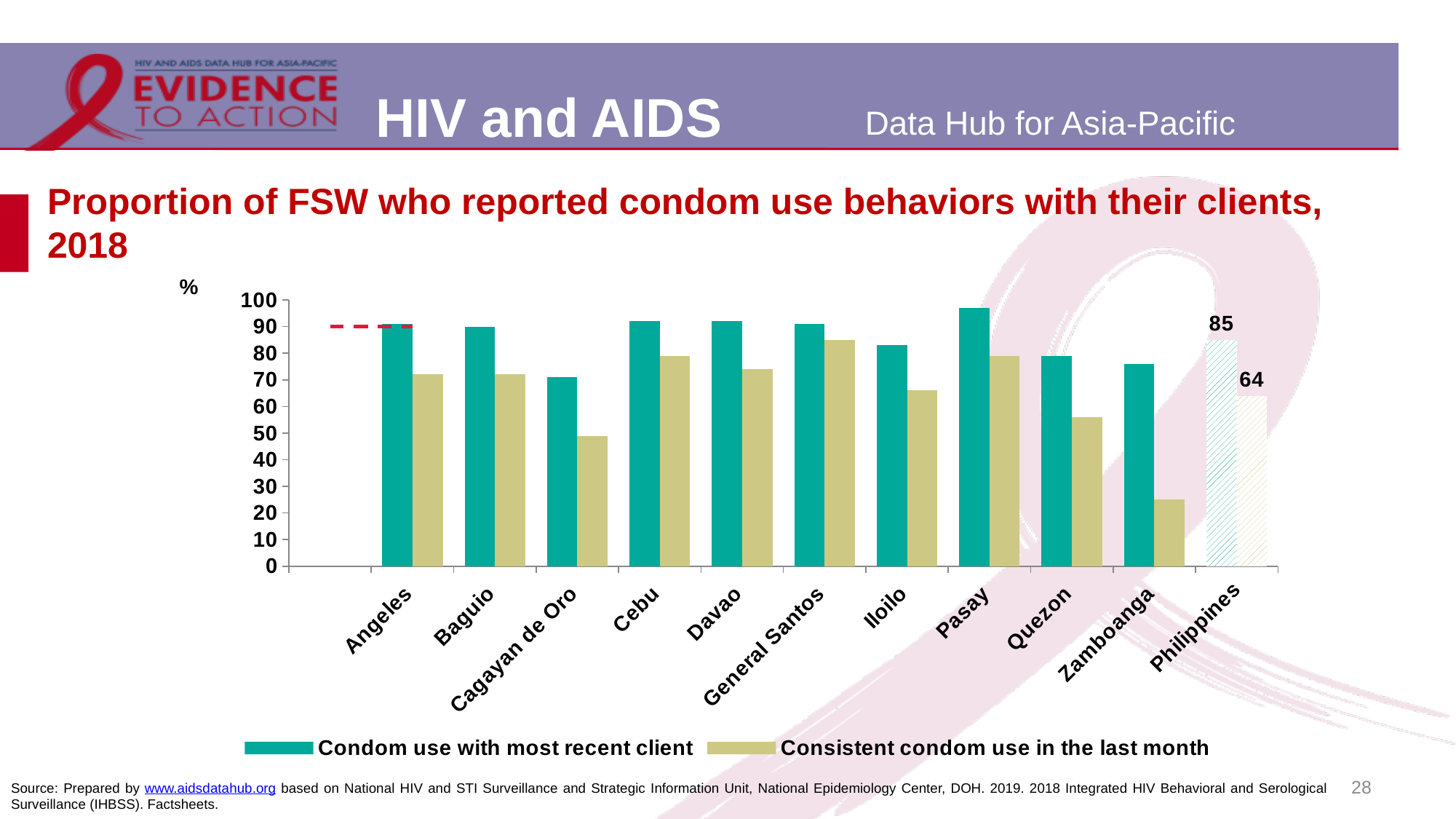
What kind of chart is shown on the slide? Bar chart Which category has the lowest value for 'Consistent condom use in the last month'? Zamboanga How many categories are shown on the x axis? 11 Which category has the highest value for 'Consistent condom use in the last month'? General Santos What is the value for Philippines in the 'Consistent condom use in the last month' series? 64 Which category has the highest value for 'Condom use with most recent client'? Pasay What are the two series named in the legend? Condom use with most recent client; Consistent condom use in the last month Which is larger for 'Condom use with most recent client': Pasay or Zamboanga? Pasay Is the value for Zamboanga in 'Consistent condom use in the last month' greater or less than 30? less What is the difference between the two Philippines values (condom use with most recent client minus consistent condom use in the last month)? 21 How many series does the legend list? 2 What is the value for Philippines in the 'Condom use with most recent client' series? 85